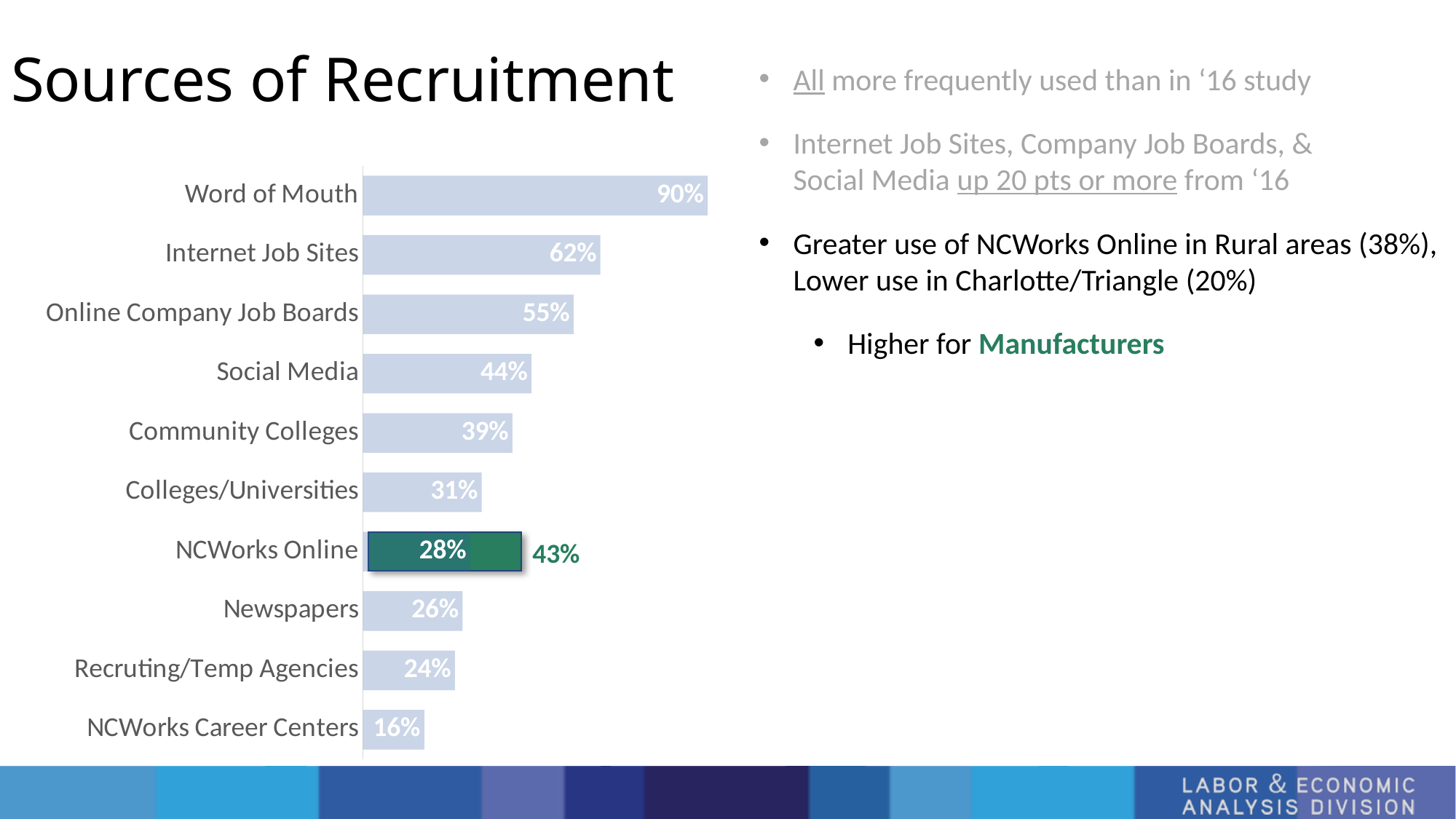
What is the difference between Word of Mouth and NCWorks Career Centers? 74% How many recruitment sources are shown in the chart? 10 What value is labeled inside the NCWorks Online bar? 28% What is the value for Social Media? 44% Which bar is highlighted in green? NCWorks Online What type of chart is shown on the slide? Bar chart What percentage is shown for Recruiting/Temp Agencies? 24% What is the difference between Internet Job Sites and Online Company Job Boards? 7% Which recruitment source has the lowest value? NCWorks Career Centers Which is larger, Community Colleges or Colleges/Universities? Community Colleges Which recruitment source has the highest value? Word of Mouth What percentage is shown for Word of Mouth? 90%